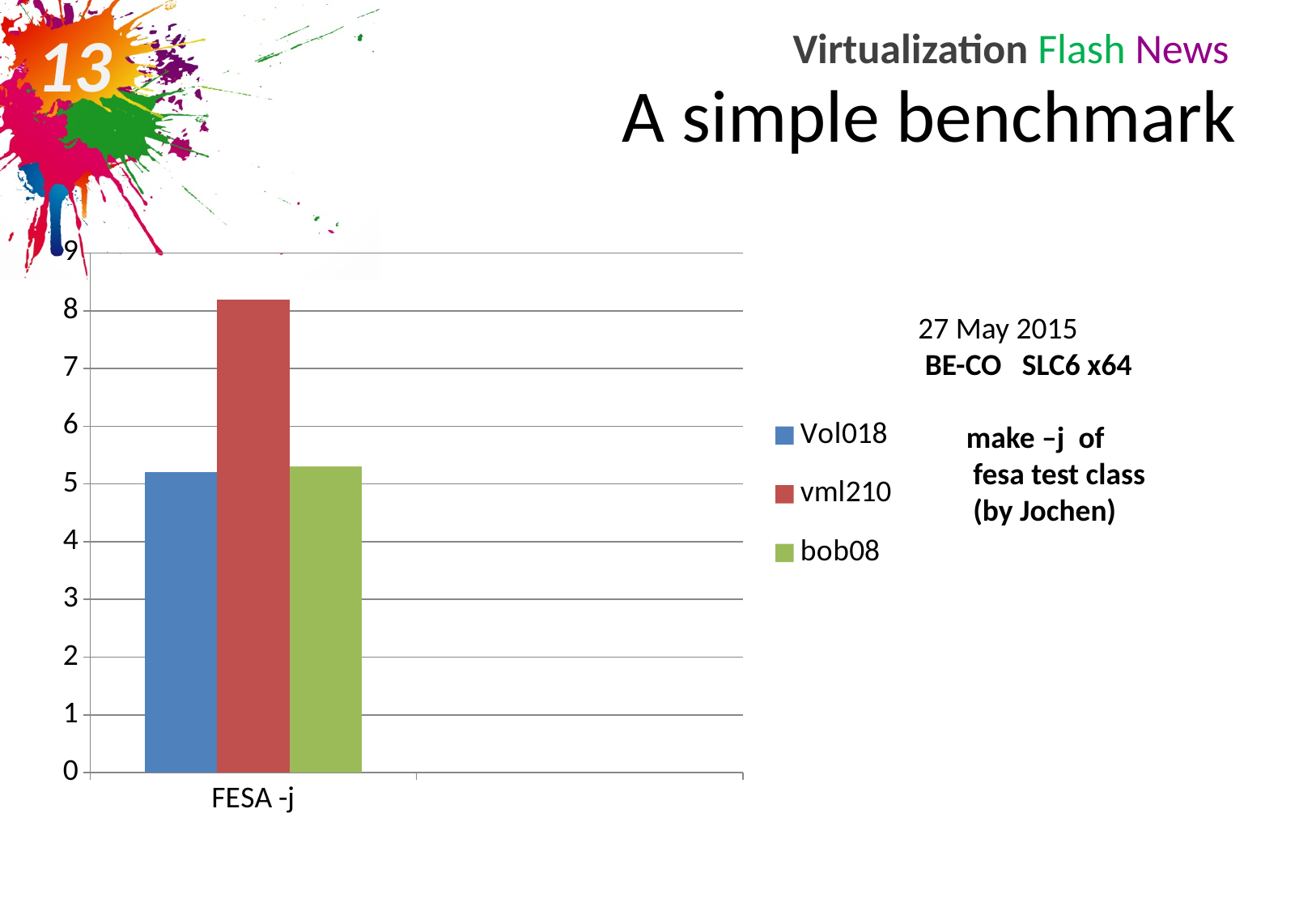
Is the value for bob08 greater or less than 6? less Is the value for Vol018 greater or less than 6? less Which is larger, the value for vml210 or the value for Vol018? vml210 Which series is shown in red? vml210 Is the value for vml210 greater or less than 7? greater What kind of chart is shown on the slide? bar chart What is the category label on the x axis? FESA -j How many categories are shown on the x axis? 1 Which is larger, the value for bob08 or the value for vml210? vml210 How many series does the legend list? 3 Which series has the highest bar for FESA -j? vml210